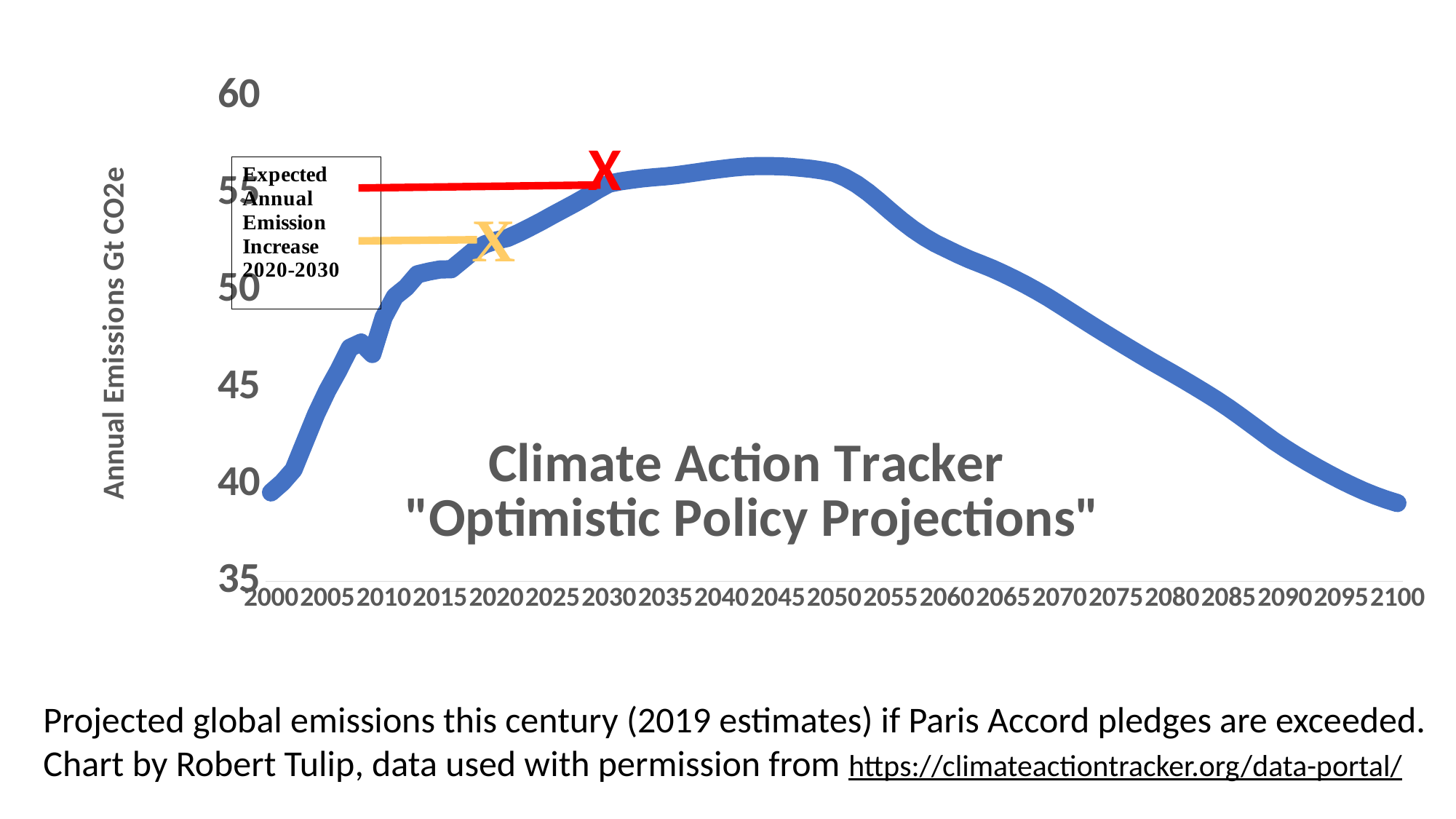
Is the value for 2080 greater or less than 45? greater Around which year on the x axis does the line reach its highest value? 2045 Do the values rise or fall along the x axis between 2050 and 2100? fall What kind of chart is shown on the slide? line chart Is the value for 2045 greater or less than 55? greater Is the value for 2020 greater or less than 50? greater What is the label on the vertical axis of the chart? Annual Emissions Gt CO2e Do the values rise or fall along the x axis between 2000 and 2040? rise Which is larger, the value for 2020 or the value for 2080? 2020 What is the title of the chart? Climate Action Tracker "Optimistic Policy Projections"